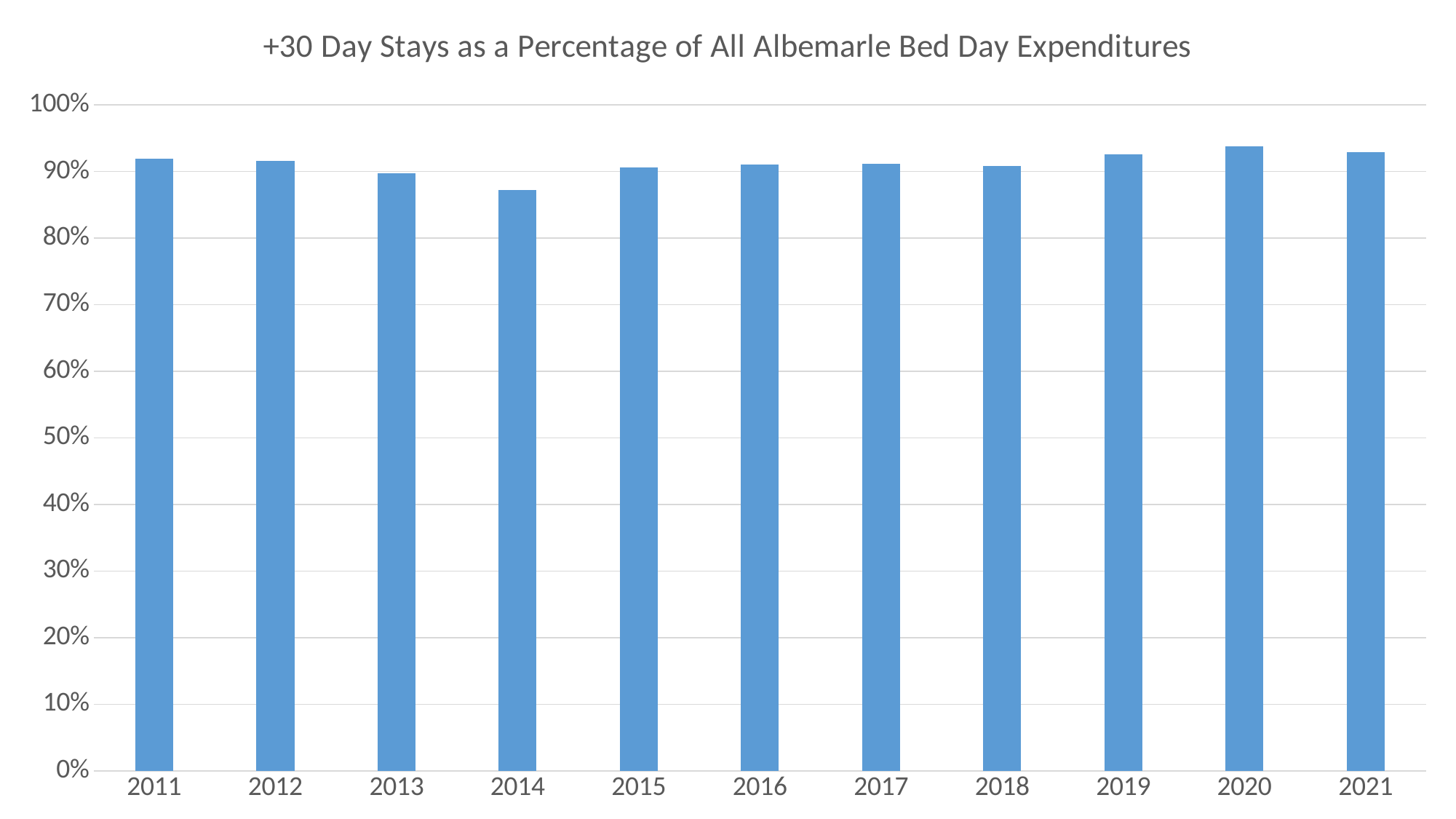
Which is larger, the value for 2014 or the value for 2020? 2020 Do the values rise or fall from 2011 to 2014? fall What is the title of the chart? +30 Day Stays as a Percentage of All Albemarle Bed Day Expenditures Is the value for 2011 greater or less than 90%? greater Is the value for 2014 greater or less than 80%? greater What kind of chart is shown on the slide? bar chart Is the value for 2020 greater or less than 90%? greater Which year has the lowest bar? 2014 Do the values rise or fall from 2018 to 2020? rise How many years are plotted on the x axis? 11 Which is larger, the value for 2013 or the value for 2014? 2013